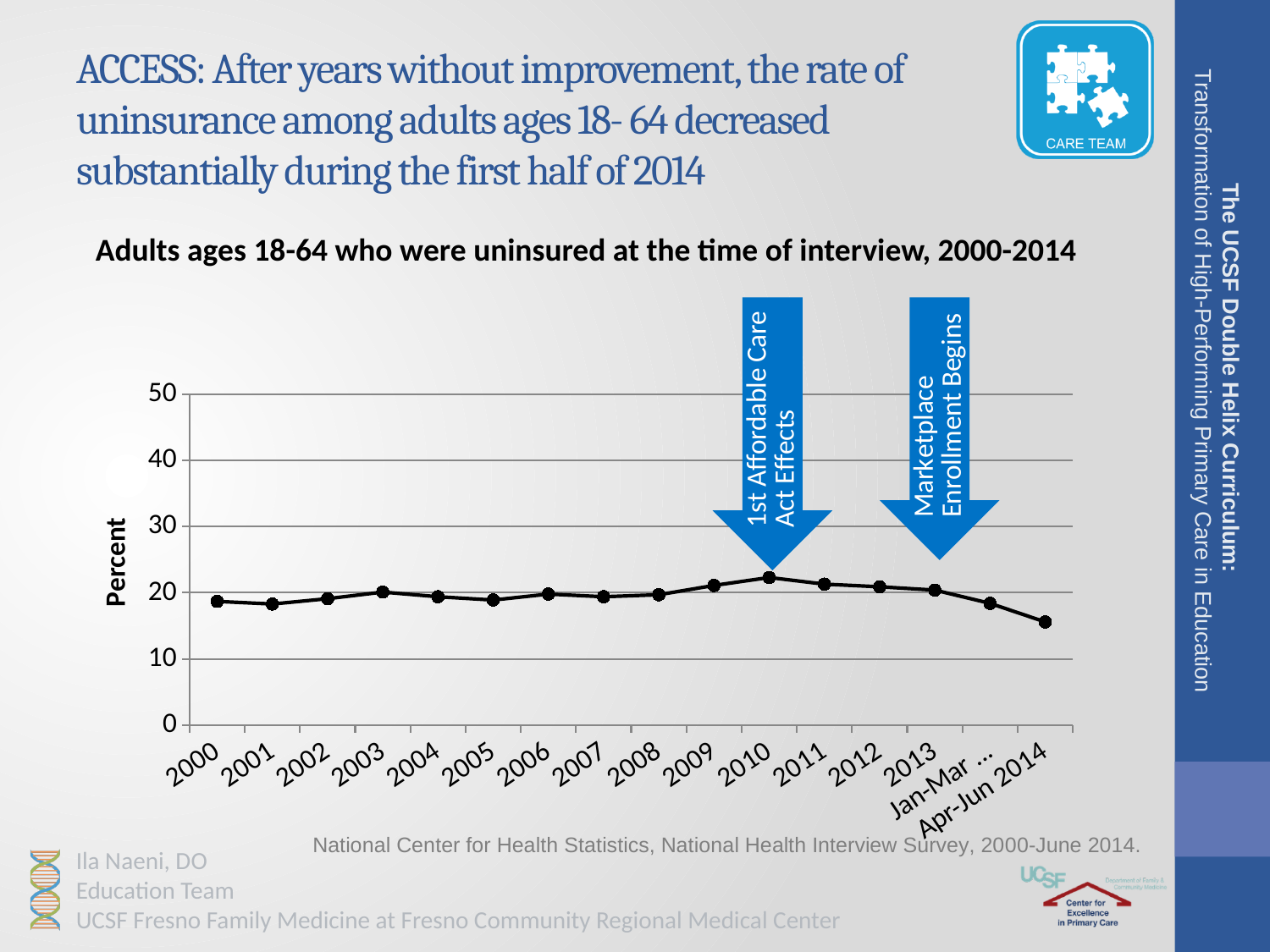
Which year has the highest value on the chart? 2010 Which is larger, the value for 2010 or the value for Apr-Jun 2014? 2010 Is the value for 2000 greater or less than 20? less How many data points are plotted on the line? 16 Do the values rise or fall from 2013 to Apr-Jun 2014? Fall Is the value for 2010 greater or less than 30? less What is the title of the chart? Adults ages 18-64 who were uninsured at the time of interview, 2000-2014 Is the value for Apr-Jun 2014 greater or less than 20? less What kind of chart is shown on the slide? Line chart What is the label on the vertical axis of the chart? Percent Which category has the lowest value on the chart? Apr-Jun 2014